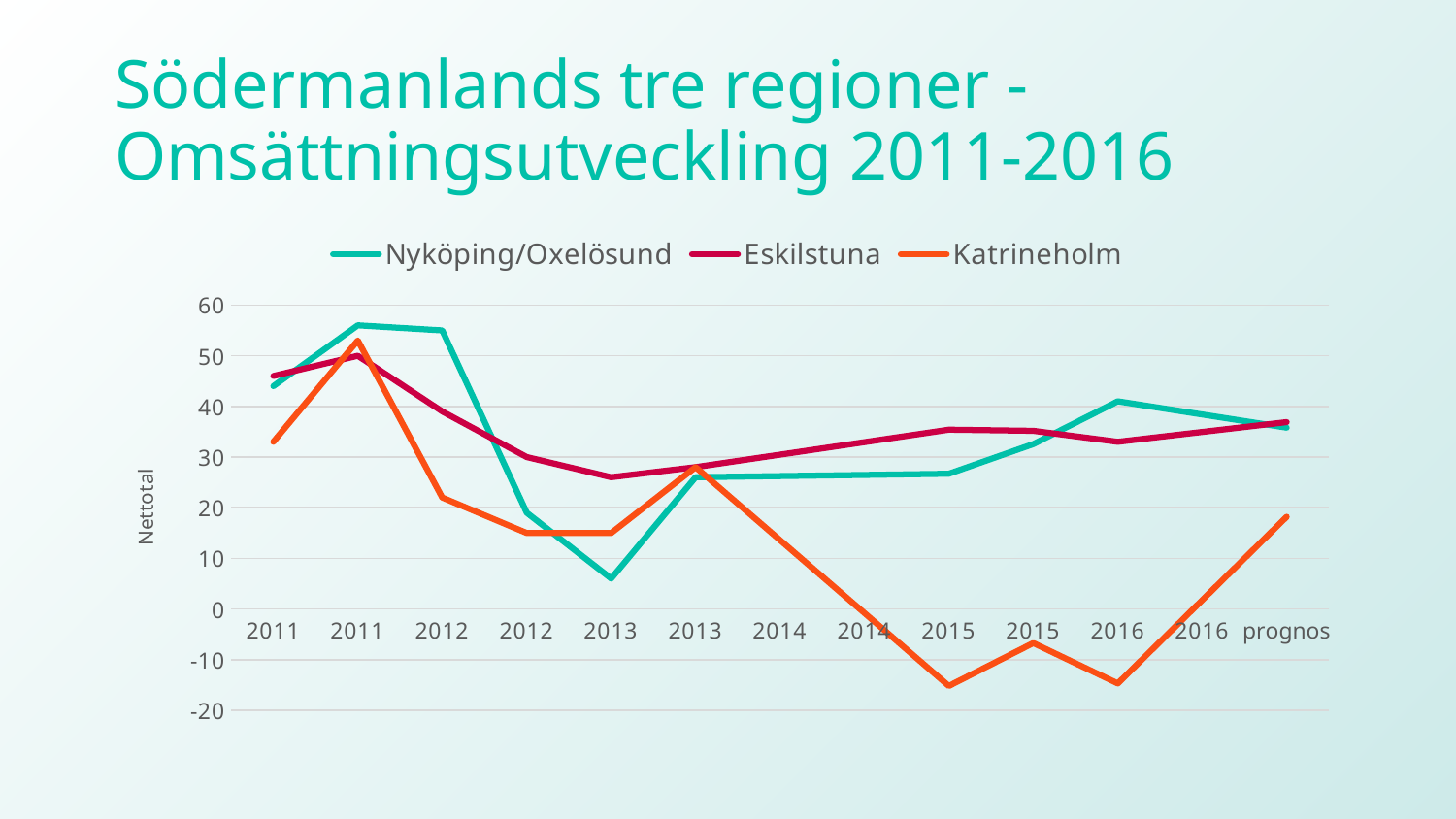
At the first 2016 point, which is larger: Nyköping/Oxelösund or Eskilstuna? Nyköping/Oxelösund At the first 2014 point, which is larger: Eskilstuna or Katrineholm? Eskilstuna Is the value for Nyköping/Oxelösund at the first 2013 point greater or less than 10? less What kind of chart is shown on the slide? line chart How many points are there along the x axis? 13 Is the value for Nyköping/Oxelösund at the second 2011 point greater or less than 50? greater Which series has the lowest value at the first 2015 point? Katrineholm Does the Katrineholm line rise or fall from the second 2013 point to the first 2015 point? fall Is the value for Katrineholm at the first 2015 point greater or less than 0? less What is the label on the vertical axis? Nettotal How many series does the legend list? 3